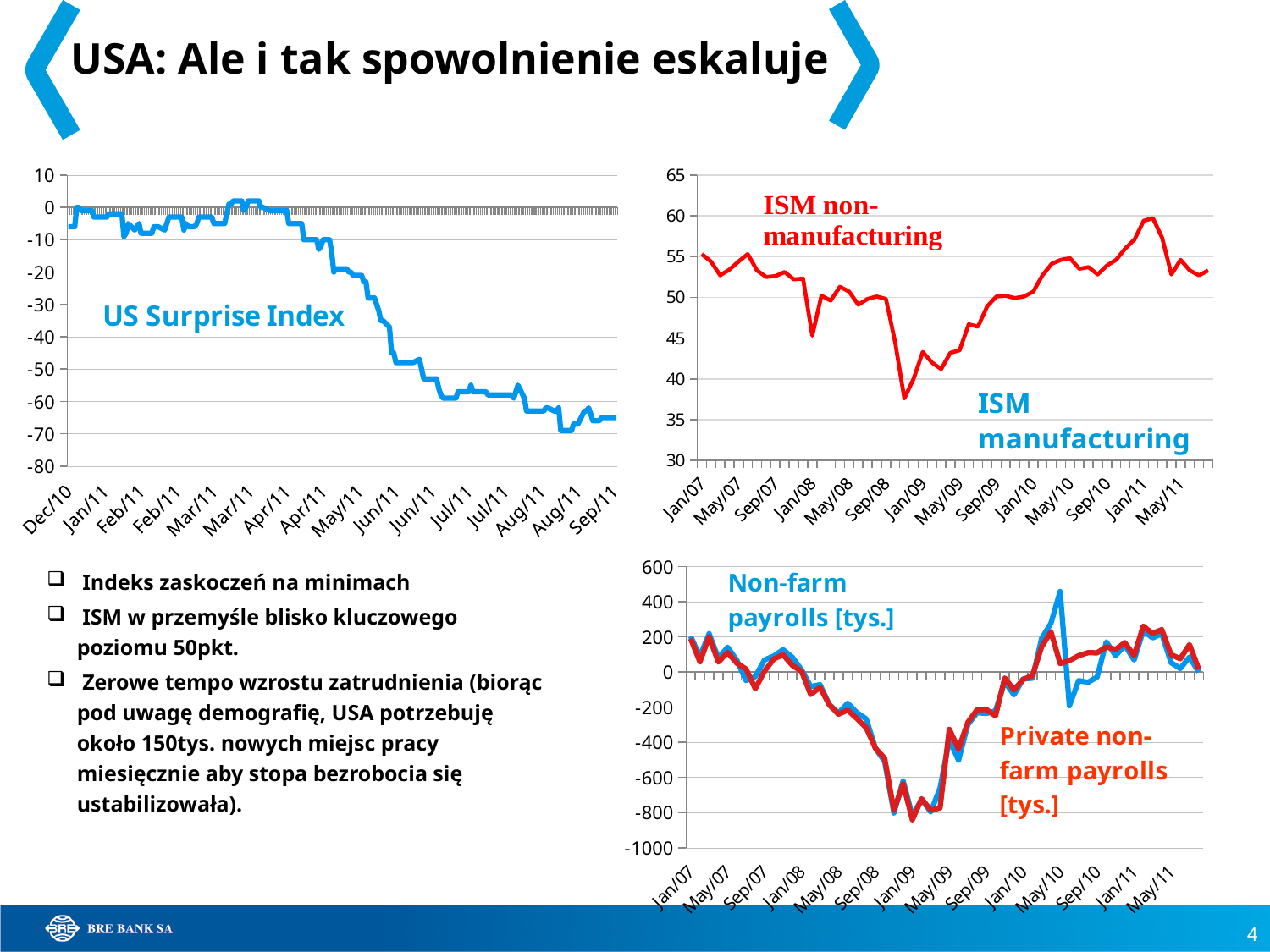
In the ISM chart at the top right, is the peak of ISM non-manufacturing around Jan/11 greater or less than 55? greater What kind of chart is the US Surprise Index chart on the left of the slide? line chart In the payrolls chart at the bottom right, is the lowest value of Non-farm payrolls (around Jan/09) greater or less than -600? less How many series are plotted in the ISM chart at the top right of the slide? 2 In the US Surprise Index chart, is the value at Dec/10 greater or less than -20? greater In the US Surprise Index chart, do the values rise or fall overall from Dec/10 to Sep/11? fall How many series are plotted in the payrolls chart at the bottom right of the slide? 2 In the payrolls chart at the bottom right, which series reaches the higher value at its spike around May/10, Non-farm payrolls or Private non-farm payrolls? Non-farm payrolls How many charts are shown on the slide? 3